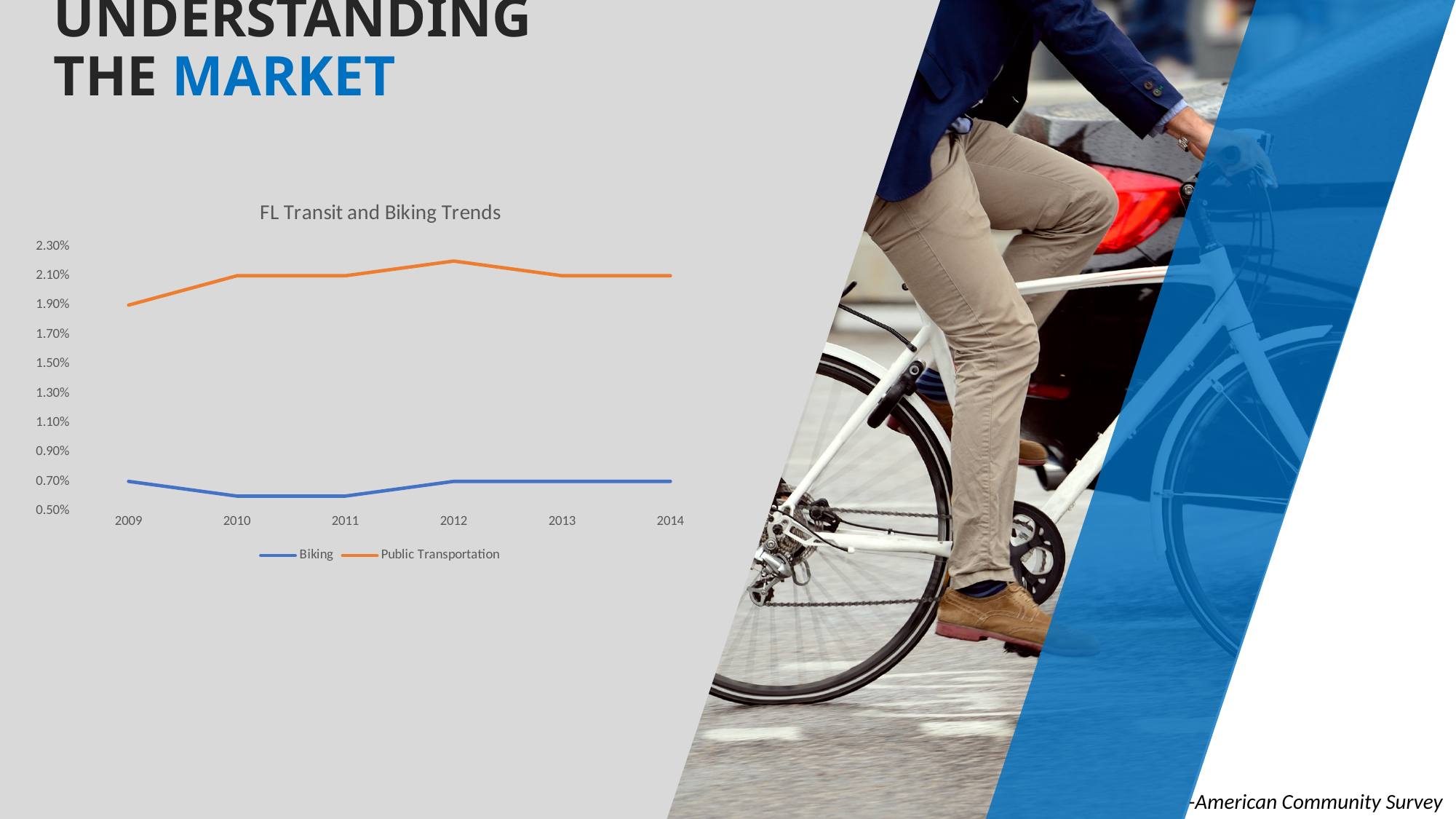
Is the Public Transportation value for 2012 greater or less than 2.10%? greater Is the Public Transportation value for 2009 greater or less than 2.10%? less Which series is drawn in orange? Public Transportation How many years are shown on the x axis? 6 What type of chart is shown on the slide? Line chart In which year is the Public Transportation value lowest? 2009 Which series has the larger value in 2014, Biking or Public Transportation? Public Transportation In which year is the Public Transportation value highest? 2012 What is the title of the chart? FL Transit and Biking Trends How many series does the legend list? 2 Does the Public Transportation line rise or fall from 2009 to 2010? Rise Is the Biking value for 2010 greater or less than 0.70%? less